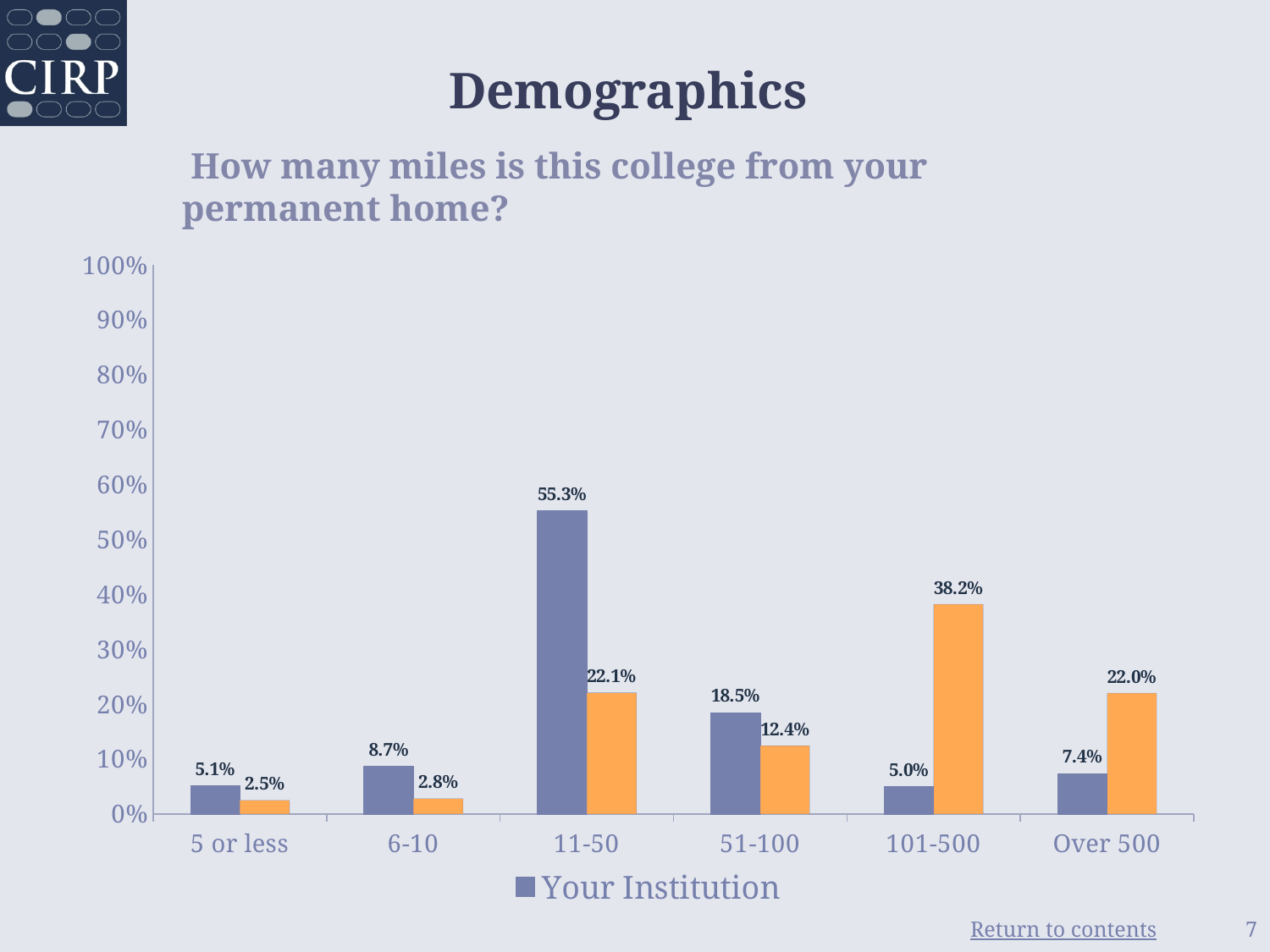
Which category has the highest value among the orange bars? 101-500 How many distance categories are shown on the x axis? 6 How many series does the legend list? 1 What is the difference between the Your Institution values for 11-50 and 51-100? 36.8 percentage points Is the value for Your Institution in the 11-50 category greater or less than 50%? greater What is the value for Your Institution in the 51-100 category? 18.5% What is the value of the orange bar in the 101-500 category? 38.2% Which category has the highest value for Your Institution? 11-50 In the 101-500 category, which is larger: the Your Institution bar or the orange bar? The orange bar What is the value for Your Institution in the 11-50 category? 55.3% What is the value for Your Institution in the Over 500 category? 7.4% What kind of chart is shown on the slide? Bar chart